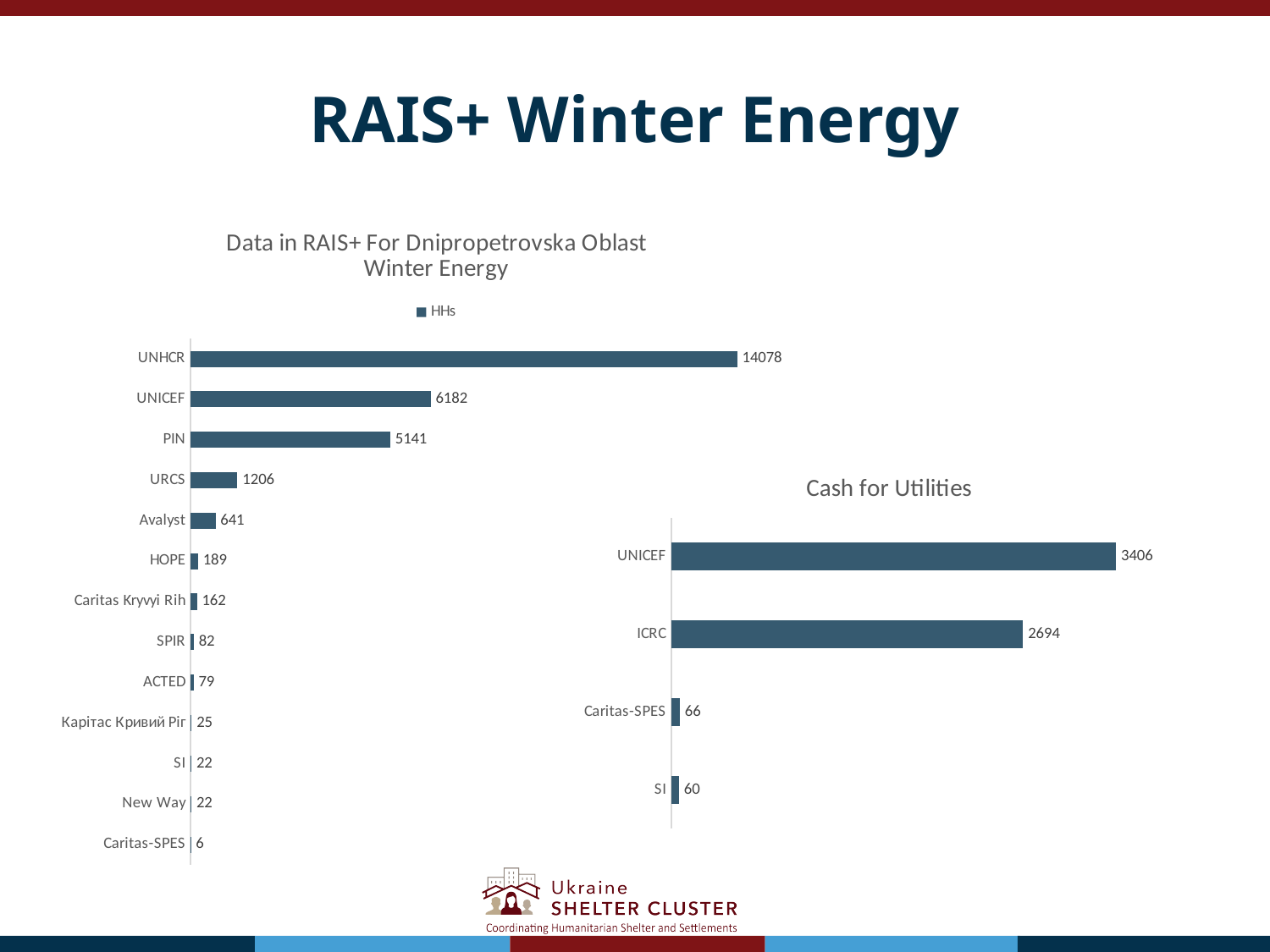
In the 'Data in RAIS+ For Dnipropetrovska Oblast Winter Energy' chart, what is the value for UNHCR? 14078 In the 'Cash for Utilities' chart, how many organisations are shown? 4 In the 'Data in RAIS+ For Dnipropetrovska Oblast Winter Energy' chart, what series does the legend show? HHs In the 'Cash for Utilities' chart, what is the difference between UNICEF and ICRC? 712 What type of chart is the 'Cash for Utilities' chart? Bar chart In the 'Data in RAIS+ For Dnipropetrovska Oblast Winter Energy' chart, which organisation has the lowest value? Caritas-SPES In the 'Cash for Utilities' chart, what is the value for ICRC? 2694 In the 'Data in RAIS+ For Dnipropetrovska Oblast Winter Energy' chart, what is the value for PIN? 5141 In the 'Data in RAIS+ For Dnipropetrovska Oblast Winter Energy' chart, what is the difference between UNICEF and PIN? 1041 In the 'Data in RAIS+ For Dnipropetrovska Oblast Winter Energy' chart, how many organisations are listed? 13 In the 'Cash for Utilities' chart, which organisation has the highest value? UNICEF In the 'Data in RAIS+ For Dnipropetrovska Oblast Winter Energy' chart, which is larger, URCS or Avalyst? URCS